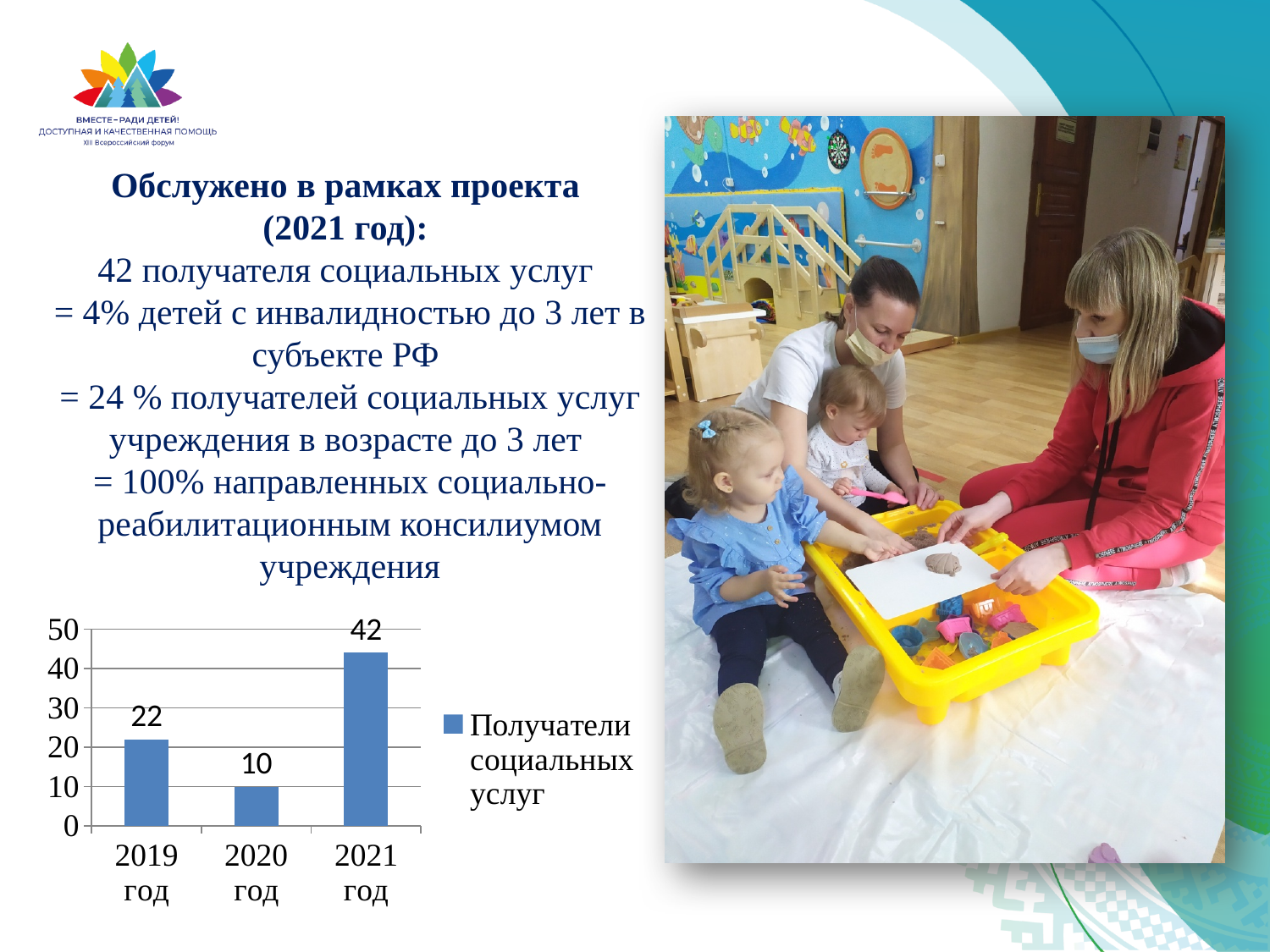
What is the value for 2020 год in the bar chart? 10 How many years are shown on the x axis of the bar chart? 3 What kind of chart is shown on the slide? bar chart What is the difference between the values for 2019 год and 2020 год? 12 Is the value for 2021 год greater or less than 30? greater Which year has the highest value in the bar chart? 2021 год What is the difference between the values for 2021 год and 2019 год? 20 How many series does the legend of the bar chart list? 1 Which year has the lowest value in the bar chart? 2020 год Which is larger, the value for 2019 год or the value for 2020 год? 2019 год What is the value for 2019 год in the bar chart? 22 What is the value for 2021 год in the bar chart? 42